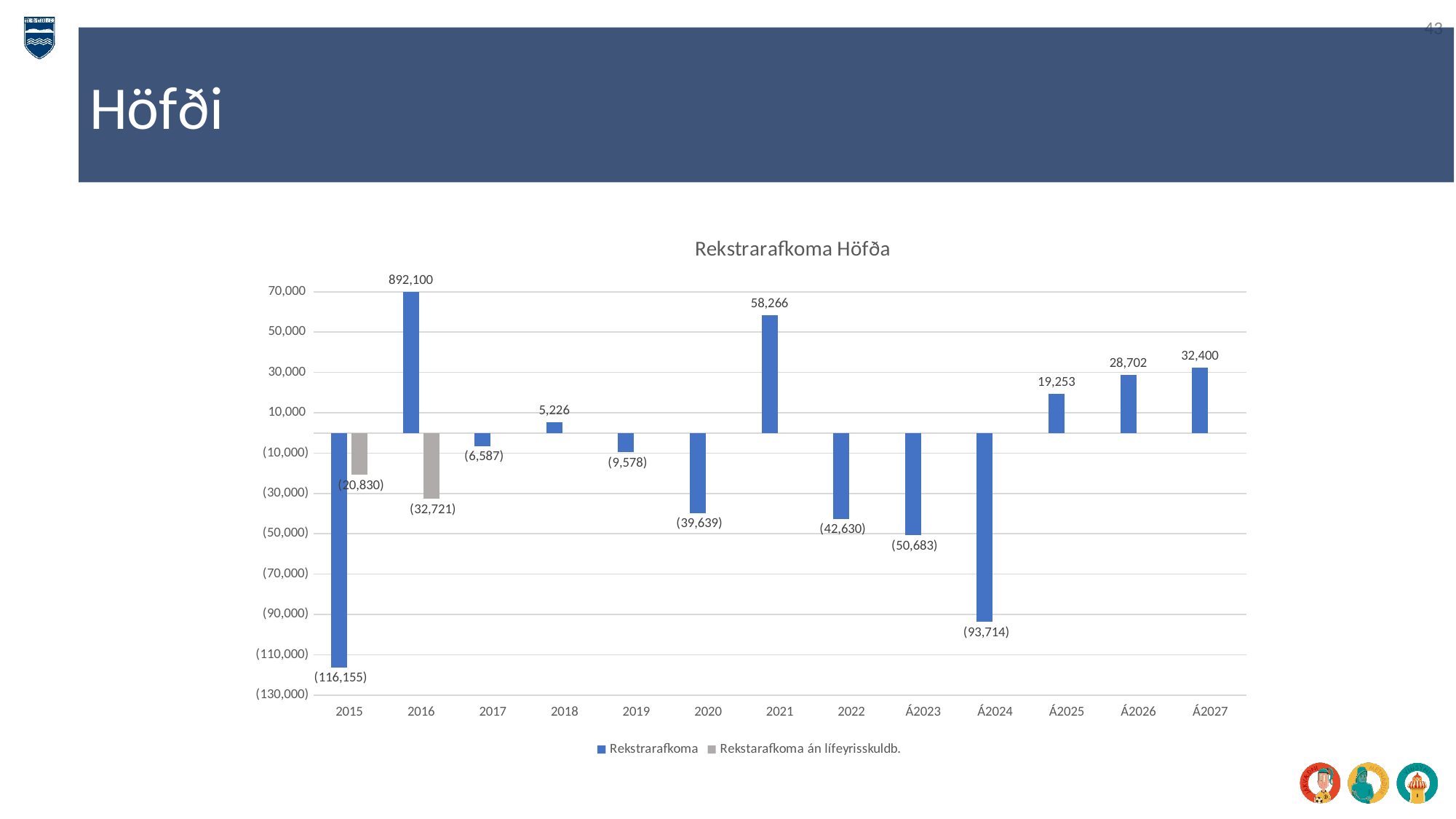
How many series does the legend list? 2 What type of chart is shown on the slide? bar chart What is the Rekstrarafkoma value for 2021? 58,266 How many categories are shown on the x axis? 13 What is the Rekstarafkoma án lífeyrisskuldb. value for 2016? (32,721) Which year has the highest Rekstrarafkoma value according to the data labels? 2016 What is the difference between the Rekstrarafkoma values for Á2027 and Á2026? 3,698 Which year has the lowest Rekstrarafkoma value? 2015 Do the Rekstrarafkoma values rise or fall from Á2025 to Á2027? rise Which is larger, the Rekstrarafkoma value for 2021 or for Á2027? 2021 What is the title of the chart? Rekstrarafkoma Höfða What is the Rekstrarafkoma value for Á2024? (93,714)